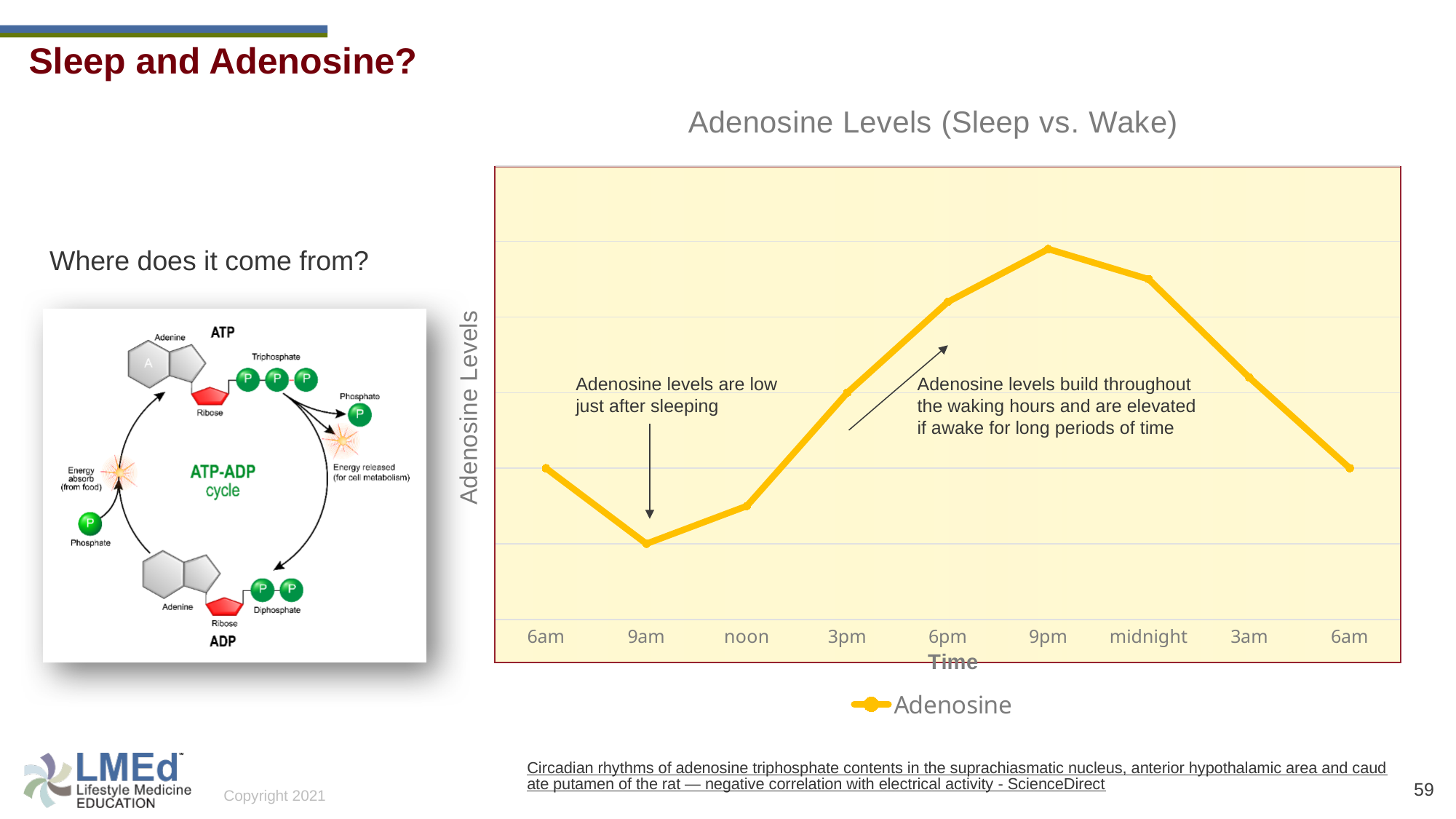
At which time is the adenosine level lowest? 9am Which has the higher adenosine level, midnight or 3pm? midnight What is the label of the x axis? Time Do adenosine levels rise or fall between 9pm and the final 6am point? Fall At which time is the adenosine level highest? 9pm What is the title of the chart? Adenosine Levels (Sleep vs. Wake) How many series does the chart's legend list? 1 What kind of chart is shown on the slide? Line chart Which has the higher adenosine level, noon or 6pm? 6pm How many time points are plotted along the x axis of the chart? 9 Do adenosine levels rise or fall between 9am and 9pm? Rise Which has the higher adenosine level, 3am or 9am? 3am